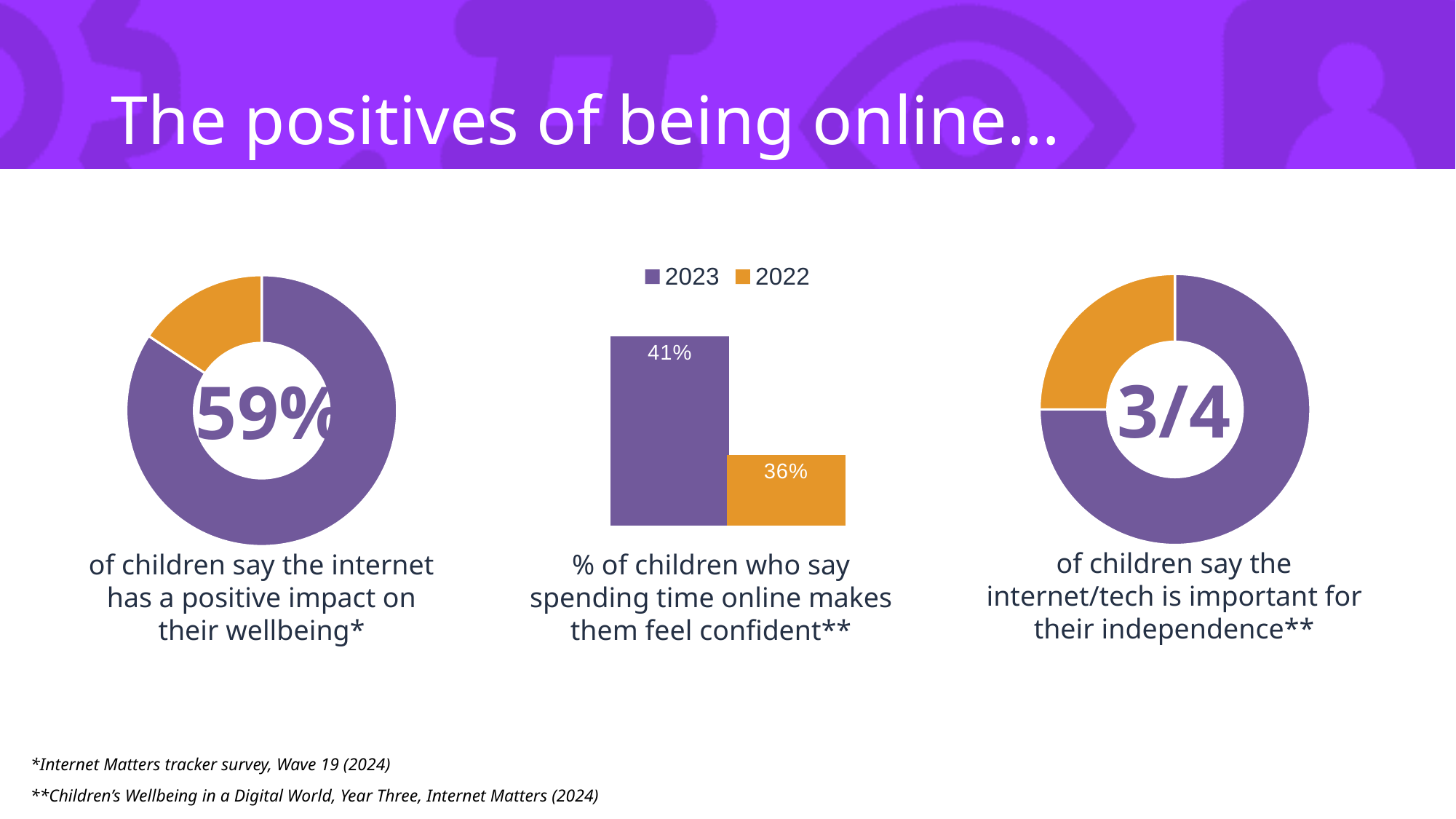
How many series does the legend of the middle bar chart list? 2 In the middle bar chart, what percentage of children said spending time online makes them feel confident in 2022? 36% In the middle bar chart, what percentage of children said spending time online makes them feel confident in 2023? 41% In the middle bar chart, which colour represents 2022 in the legend? orange In the middle bar chart, which year has the higher value? 2023 How many bars are plotted in the middle bar chart? 2 In the middle bar chart, what is the difference between the 2023 and 2022 values? 5% In the middle bar chart, is the 2022 value larger or smaller than the 2023 value? smaller What value is shown in the centre of the right donut chart about the internet/tech being important for independence? 3/4 What kind of chart is the middle chart on the slide? bar chart In the middle bar chart, which year has the lower value? 2022 What value is shown in the centre of the left donut chart about the internet having a positive impact on wellbeing? 59%